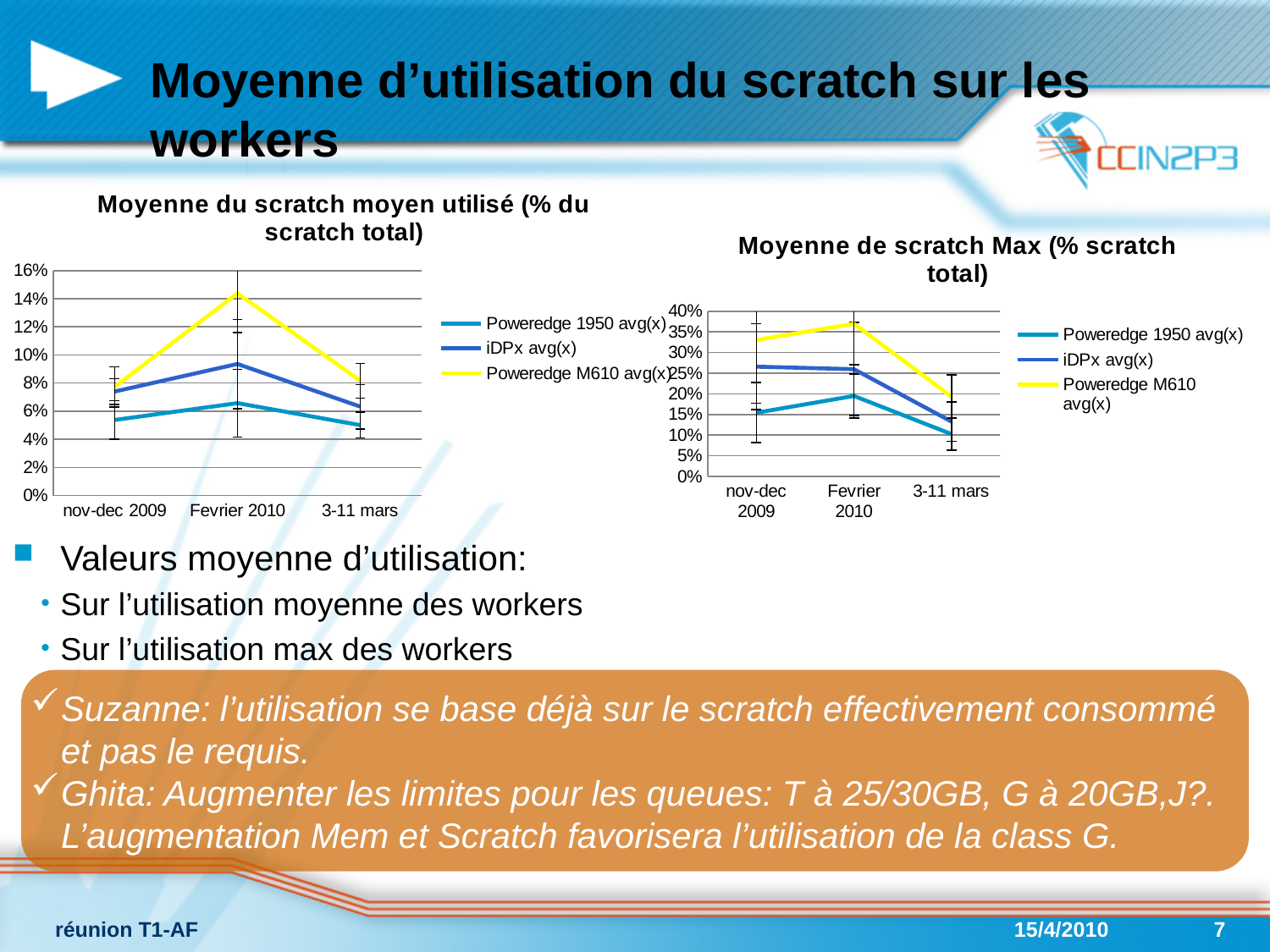
In the left chart, 'Moyenne du scratch moyen utilisé', is the value for Poweredge 1950 avg(x) at nov-dec 2009 greater or less than 8%? less In the right chart, 'Moyenne de scratch Max (% scratch total)', is the value for Poweredge 1950 avg(x) at 3-11 mars greater or less than 15%? less What is the title of the chart on the right side of the slide? Moyenne de scratch Max (% scratch total) In the right chart, 'Moyenne de scratch Max (% scratch total)', which series has the lowest value at 3-11 mars? Poweredge 1950 avg(x) What kind of chart is the left chart, 'Moyenne du scratch moyen utilisé (% du scratch total)'? line chart In the left chart, 'Moyenne du scratch moyen utilisé', is the value for Poweredge M610 avg(x) at Fevrier 2010 greater or less than 12%? greater How many series does the legend of the left chart, 'Moyenne du scratch moyen utilisé', list? 3 In the left chart, 'Moyenne du scratch moyen utilisé', which series has the highest value at Fevrier 2010? Poweredge M610 avg(x) In the right chart, 'Moyenne de scratch Max (% scratch total)', which is larger at nov-dec 2009: iDPx avg(x) or Poweredge 1950 avg(x)? iDPx avg(x) How many categories are shown on the x axis of the left chart, 'Moyenne du scratch moyen utilisé'? 3 In the left chart, 'Moyenne du scratch moyen utilisé', does the Poweredge M610 avg(x) line rise or fall from Fevrier 2010 to 3-11 mars? fall